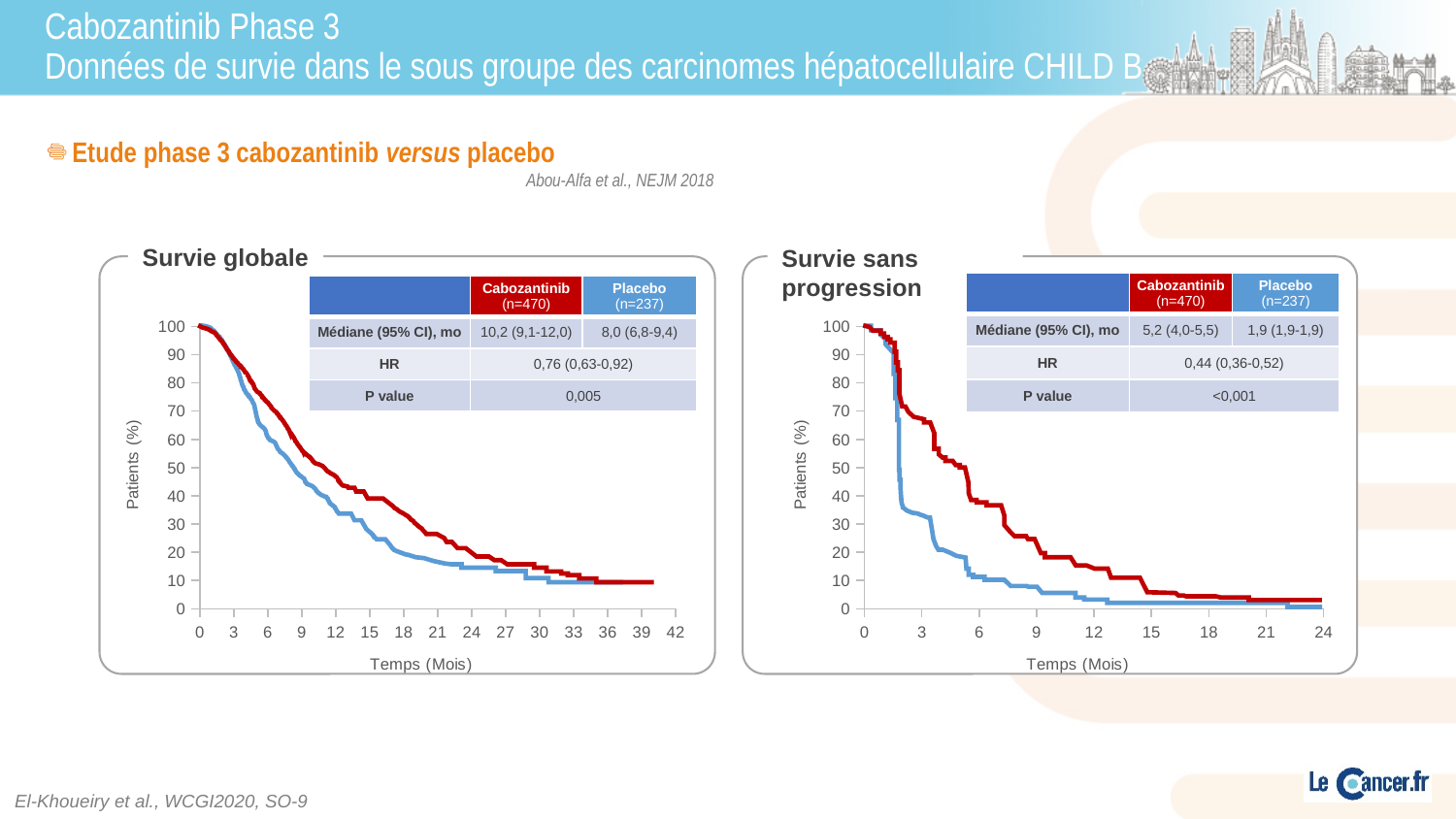
In the 'Survie globale' chart, do the curves rise or fall as time (Temps, Mois) increases? Fall In the 'Survie sans progression' chart, what is the median (95% CI) in months for Placebo? 1,9 (1,9-1,9) In the 'Survie globale' chart, what is the median overall survival (95% CI) in months for Placebo? 8,0 (6,8-9,4) In the 'Survie sans progression' chart, is the Placebo (blue) curve at 3 months greater or less than 50%? less In the 'Survie globale' chart, what is the median overall survival (95% CI) in months for Cabozantinib? 10,2 (9,1-12,0) In the 'Survie sans progression' chart, what is the P value shown in the table? <0,001 In the 'Survie sans progression' chart, which curve is higher at 6 months, Cabozantinib (red) or Placebo (blue)? Cabozantinib (red) In the 'Survie globale' chart, what is the hazard ratio (HR) shown in the table? 0,76 (0,63-0,92) In the 'Survie sans progression' chart, what is the hazard ratio (HR) shown in the table? 0,44 (0,36-0,52) How many treatment groups (series) are plotted in the 'Survie globale' chart? 2 What kind of chart is the 'Survie globale' chart? Line chart In the 'Survie globale' chart, is the Cabozantinib (red) curve at 12 months greater or less than 50%? less